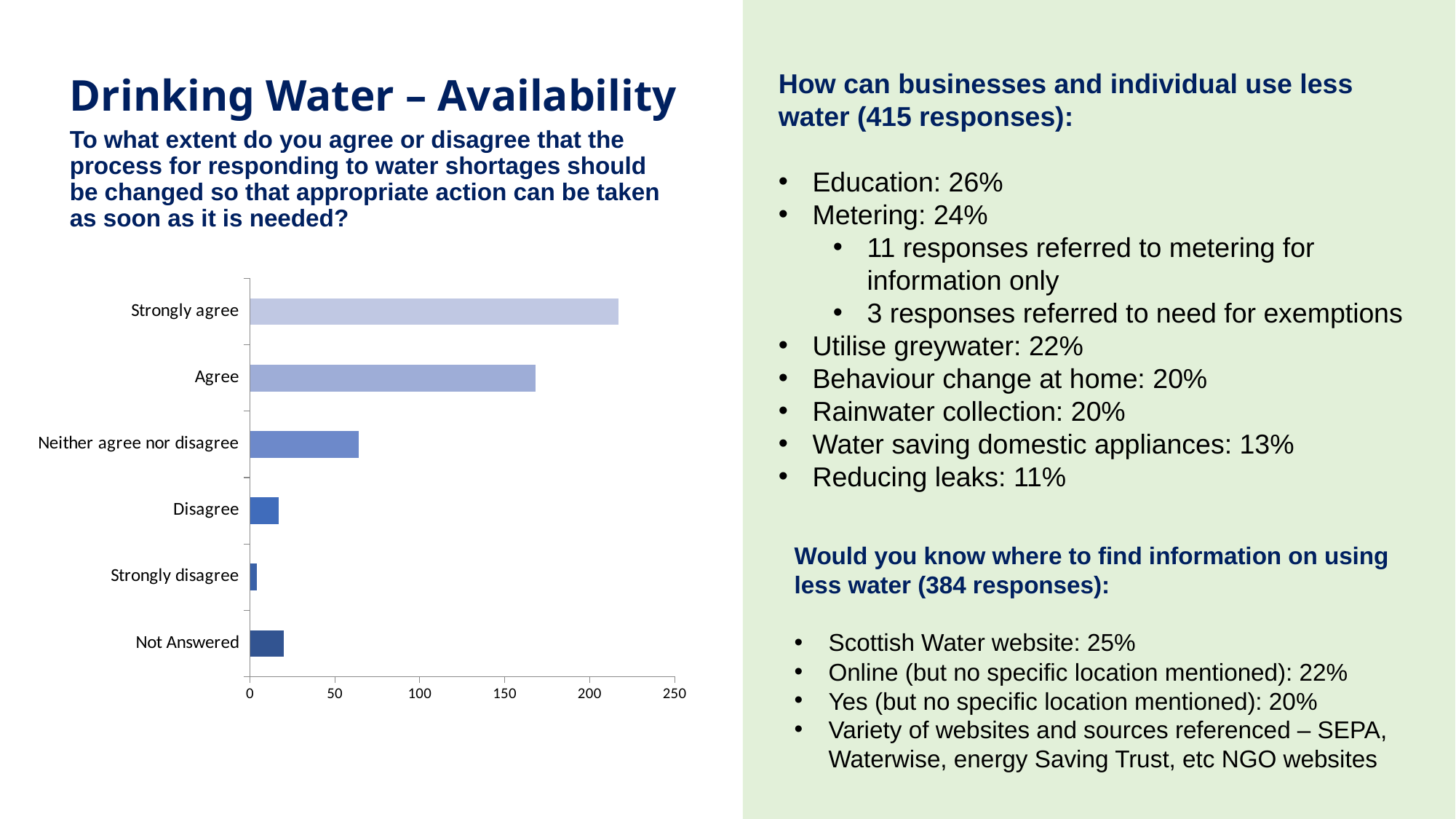
Is the value for Strongly agree greater or less than 200? greater Which is larger, the value for Agree or the value for Neither agree nor disagree? Agree Which category has the lowest value on the chart? Strongly disagree Which category has the highest value on the chart? Strongly agree Is the value for Neither agree nor disagree greater or less than 50? greater How many categories are shown on the chart? 6 What is the highest value shown on the chart's horizontal axis? 250 Is the value for Agree greater or less than 150? greater What kind of chart is shown on the slide? bar chart